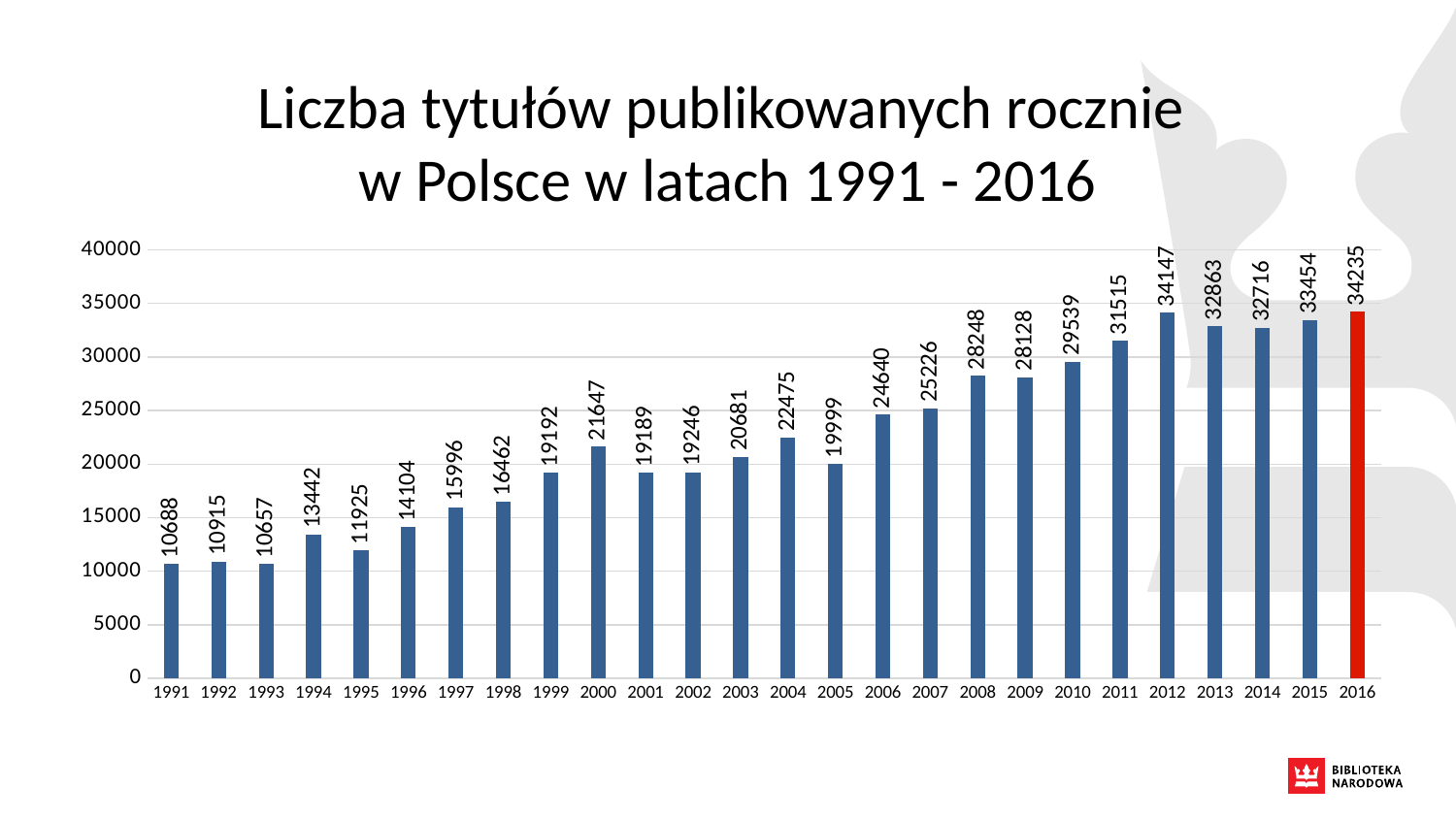
What kind of chart is this? bar chart What is the difference between the values for 2016 and 2015? 781 What is the difference between the values for 2012 and 2011? 2632 What is the value for 1991? 10688 Which year has the highest value? 2016 Which bar is coloured red instead of blue? 2016 What is the value for 2008? 28248 How many years are shown on the x axis? 26 Which year has the lowest value? 1993 Which is larger, the value for 2013 or the value for 2014? 2013 What is the value for 2000? 21647 What is the value for 2016? 34235